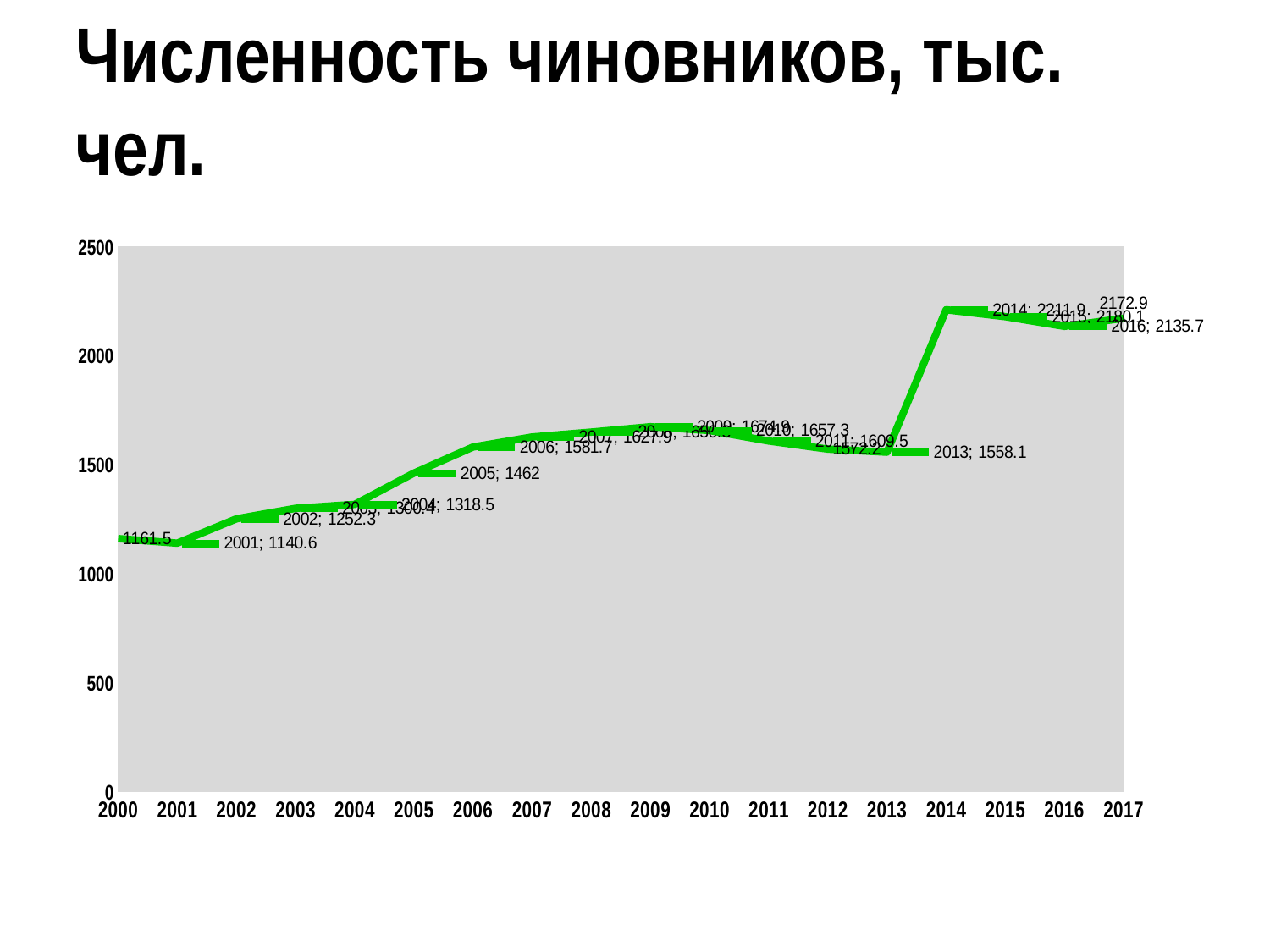
Which is larger, the value for 2006 or the value for 2005? 2006 Which year has the highest value? 2014 What is the value for 2001? 1140.6 Which year has the lowest value? 2001 What is the value for 2005? 1462 Is the value for 2013 greater or less than 2000? less What kind of chart is shown on the slide? line chart What is the value for 2013? 1558.1 What is the value for 2014? 2211.9 What is the difference between the values for 2014 and 2013? 653.8 What is the value for 2016? 2135.7 Do the values rise or fall from 2010 to 2013? fall